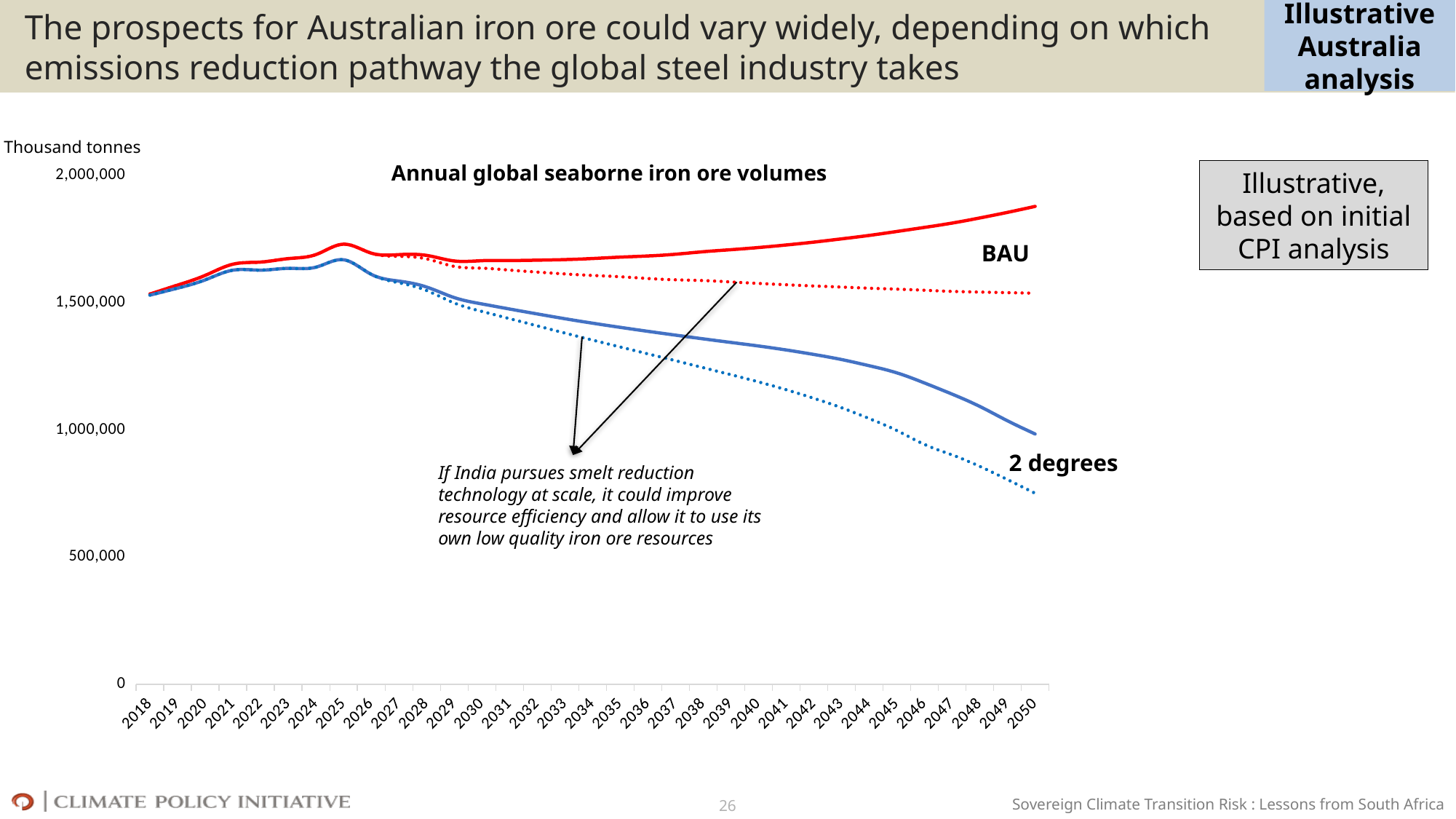
Does the solid 2 degrees line rise or fall between 2030 and 2050? fall What is the last year shown on the x axis? 2050 Does the solid BAU line rise or fall between 2030 and 2050? rise In 2050, which scenario has the higher seaborne iron ore volume, BAU or 2 degrees? BAU How many years are shown along the x axis of the chart? 33 Is the value of the solid 2 degrees line in 2040 greater or less than 1,000,000? greater What is the first year shown on the x axis? 2018 What unit is shown for the vertical axis of the chart? Thousand tonnes What is the title of the chart? Annual global seaborne iron ore volumes Is the value of the solid BAU line in 2050 greater or less than 1,500,000? greater What kind of chart is shown on the slide? line chart